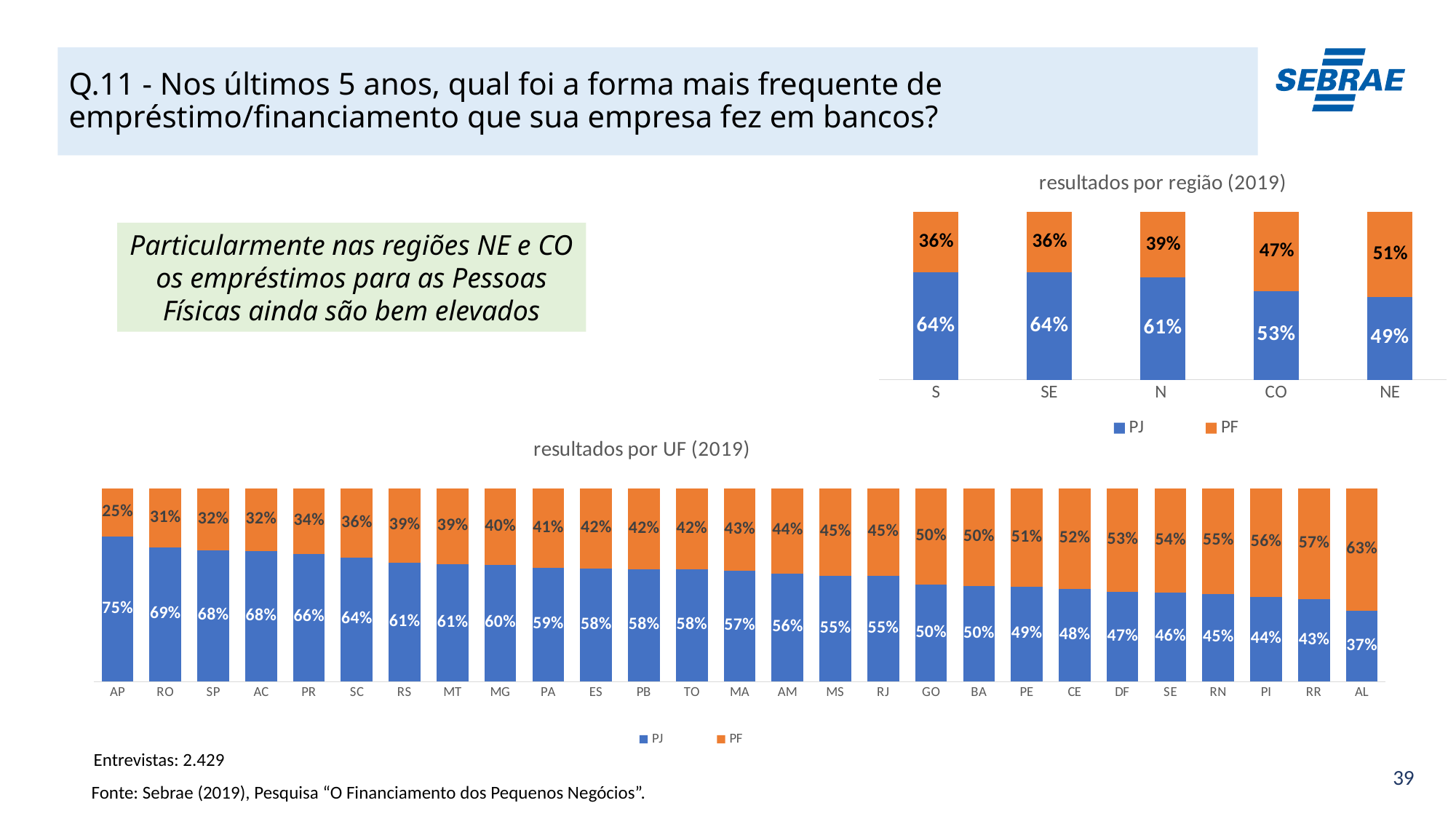
How many series does the legend of the 'resultados por UF (2019)' chart list? 2 In the 'resultados por região (2019)' chart, what is the PF value for region NE? 51% In the 'resultados por UF (2019)' chart, what is the PF value for AL? 63% In the 'resultados por UF (2019)' chart, how many UFs are shown? 27 In the 'resultados por UF (2019)' chart, what is the PJ value for AP? 75% In the 'resultados por UF (2019)' chart, which UF has the lowest PJ value? AL In the 'resultados por UF (2019)' chart, is the PJ value for RJ larger or the PJ value for CE? RJ In the 'resultados por região (2019)' chart, which region has the highest PF value? NE In the 'resultados por região (2019)' chart, what is the PJ value for region S? 64% In the 'resultados por região (2019)' chart, how many regions are shown? 5 In the 'resultados por região (2019)' chart, what is the difference between the PF values for CO and N? 8% In the 'resultados por região (2019)' chart, which region has the lowest PJ value? NE